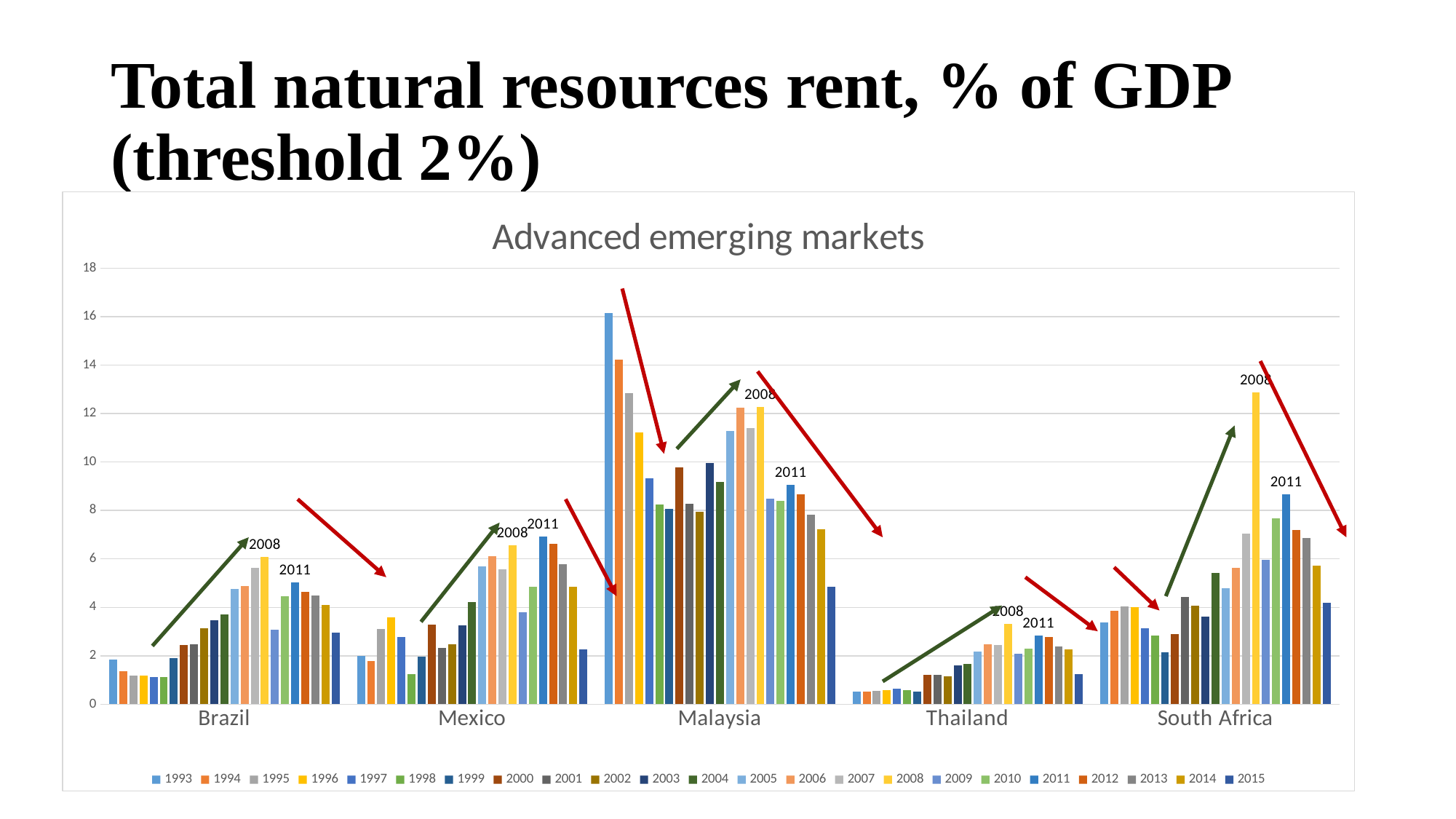
Is the value for Mexico in 2011 greater or less than 8? less Which country has the lowest bars overall in the chart? Thailand What is the title of the chart? Advanced emerging markets Is the value for South Africa in 2008 greater or less than 12? greater How many years (series) does the legend list? 23 How many countries are shown on the x axis of the chart? 5 Is the value for Thailand in 2008 greater or less than 2? greater Which is larger: the 2008 value for Thailand or the 2008 value for South Africa? South Africa What type of chart is shown on the slide? Bar chart Which country has the tallest bar in the chart? Malaysia Which is larger: the 1993 value for Malaysia or the 2008 value for South Africa? Malaysia